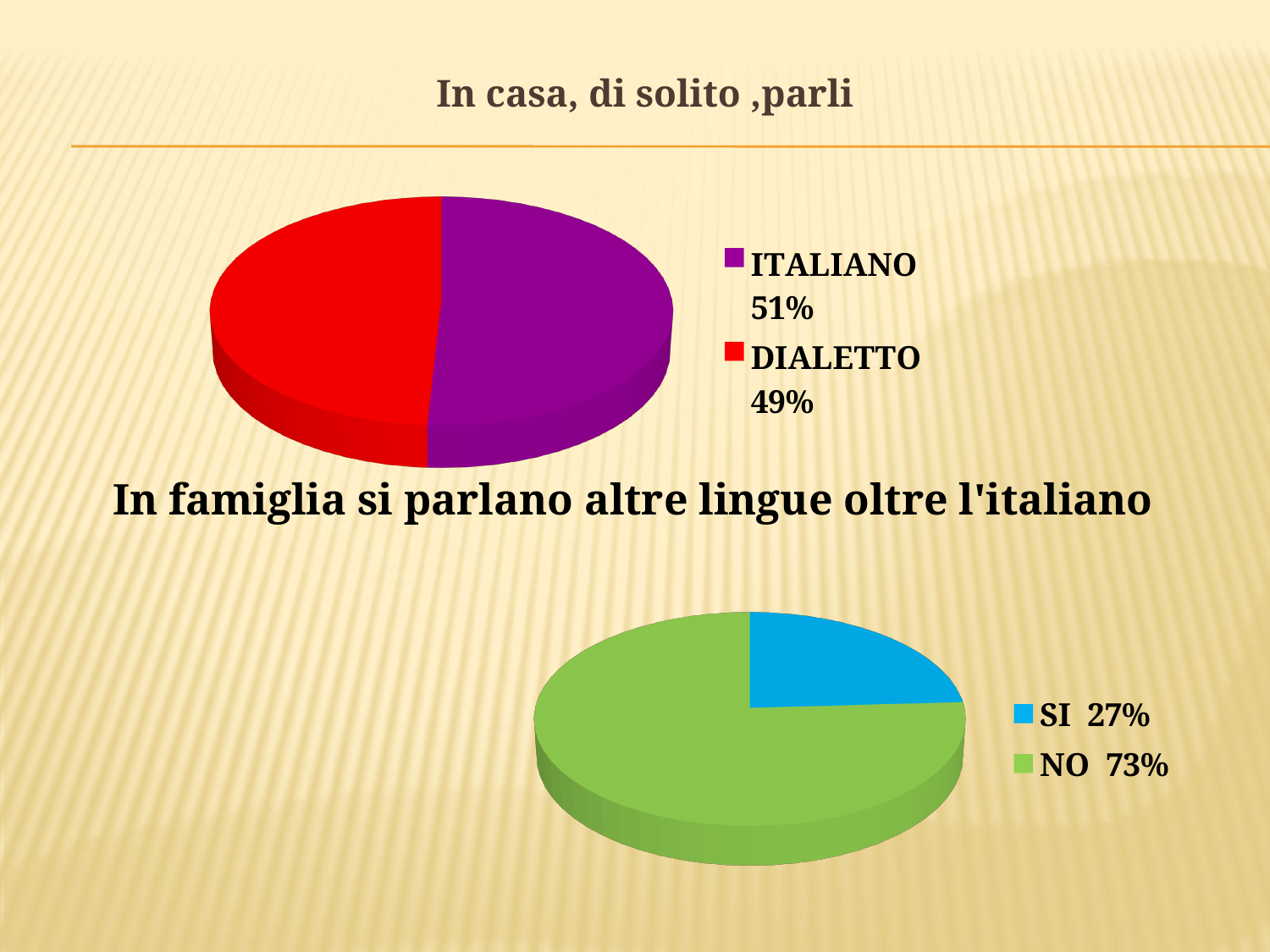
What type of chart is the bottom chart ('In famiglia si parlano altre lingue oltre l'italiano')? Pie chart In the bottom chart ('In famiglia si parlano altre lingue oltre l'italiano'), what is the difference in percentage points between NO and SI? 46 In the top chart ('In casa, di solito, parli'), what is the difference in percentage points between ITALIANO and DIALETTO? 2 In the bottom chart ('In famiglia si parlano altre lingue oltre l'italiano'), which category has the largest share? NO In the bottom chart ('In famiglia si parlano altre lingue oltre l'italiano'), what colour represents the SI slice? Blue In the bottom chart ('In famiglia si parlano altre lingue oltre l'italiano'), what percentage is shown for NO? 73% In the top chart ('In casa, di solito, parli'), what percentage is shown for ITALIANO? 51% In the top chart ('In casa, di solito, parli'), which category has the larger share, ITALIANO or DIALETTO? ITALIANO In the top chart ('In casa, di solito, parli'), how many categories does the legend list? 2 In the bottom chart ('In famiglia si parlano altre lingue oltre l'italiano'), what percentage is shown for SI? 27% What type of chart is the top chart ('In casa, di solito, parli')? Pie chart In the top chart ('In casa, di solito, parli'), what percentage is shown for DIALETTO? 49%